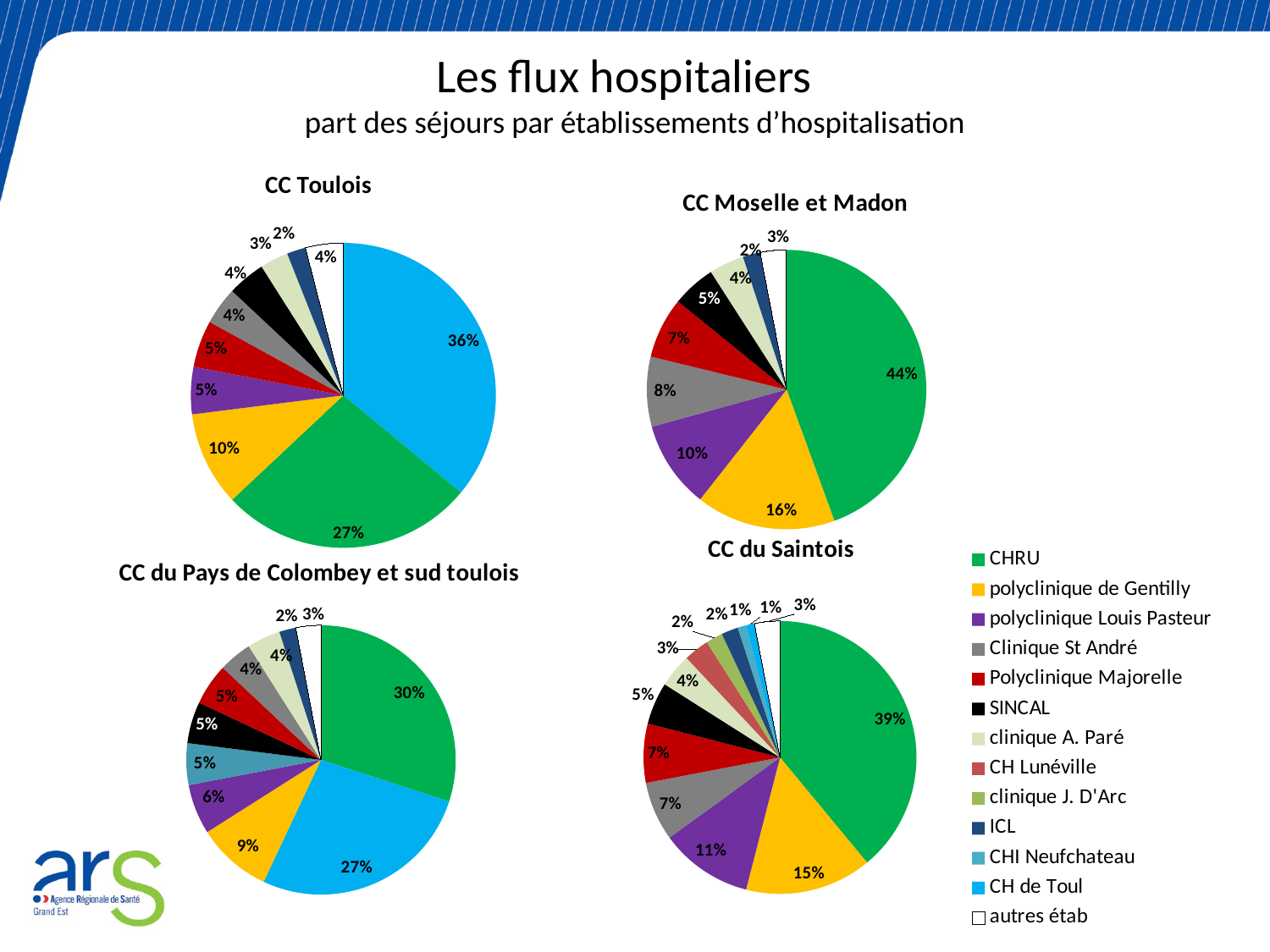
In the CC du Pays de Colombey et sud touloi pie chart, which is larger: the CHRU share or the CH de Toul share? CHRU In the CC Toulois pie chart, what share of stays goes to CH de Toul? 36% How many entries does the shared legend list? 13 How many pie charts are shown on the slide? 4 In the CC Toulois pie chart, what share of stays goes to 'autres étab'? 4% In the CC du Saintois pie chart, which establishment has the largest share? CHRU In the CC Toulois pie chart, which establishment has the largest share? CH de Toul In the CC du Saintois pie chart, what share of stays goes to polyclinique Louis Pasteur? 11% In the CC Moselle et Madon pie chart, what share of stays goes to CHRU? 44% What kind of chart is used for CC Moselle et Madon? Pie chart In the CC Moselle et Madon pie chart, what is the difference between the CHRU share and the polyclinique de Gentilly share? 28% In the CC du Pays de Colombey et sud touloi pie chart, what share of stays goes to polyclinique de Gentilly? 9%